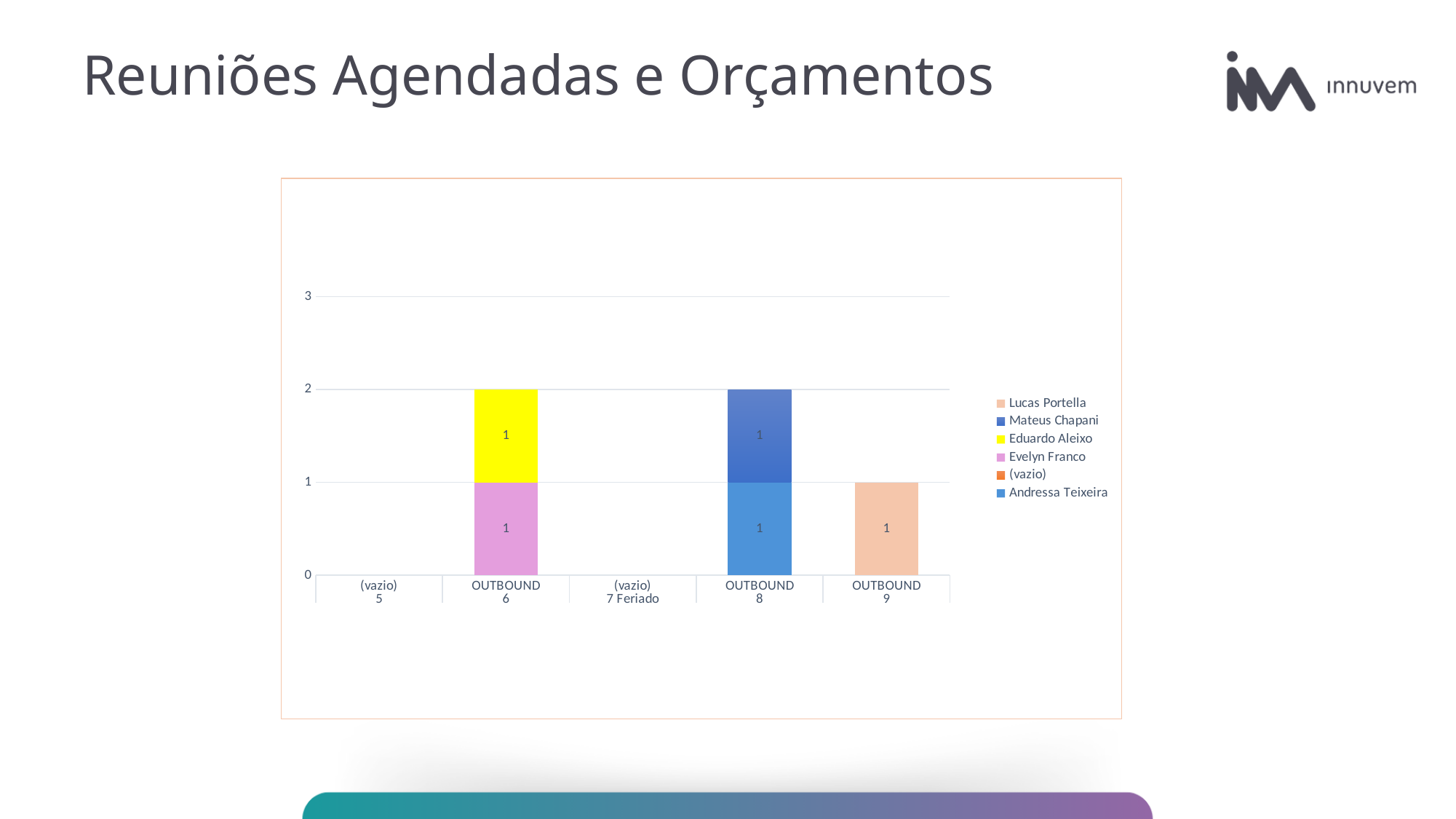
What kind of chart is shown on the slide? Stacked bar chart What is the value for Eduardo Aleixo in the OUTBOUND 6 category? 1 What is the value for Lucas Portella in the OUTBOUND 9 category? 1 How many categories are shown on the x axis? 5 How many series does the legend list? 6 What is the total of the stacked bar for OUTBOUND 8? 2 What is the total of the stacked bar for OUTBOUND 6? 2 What is the value for Evelyn Franco in the OUTBOUND 6 category? 1 What is the title of the slide containing the chart? Reuniões Agendadas e Orçamentos What is the value for Mateus Chapani in the OUTBOUND 8 category? 1 What is the difference between the total for OUTBOUND 6 and the total for OUTBOUND 9? 1 Which is larger, the total for OUTBOUND 8 or the total for OUTBOUND 9? OUTBOUND 8